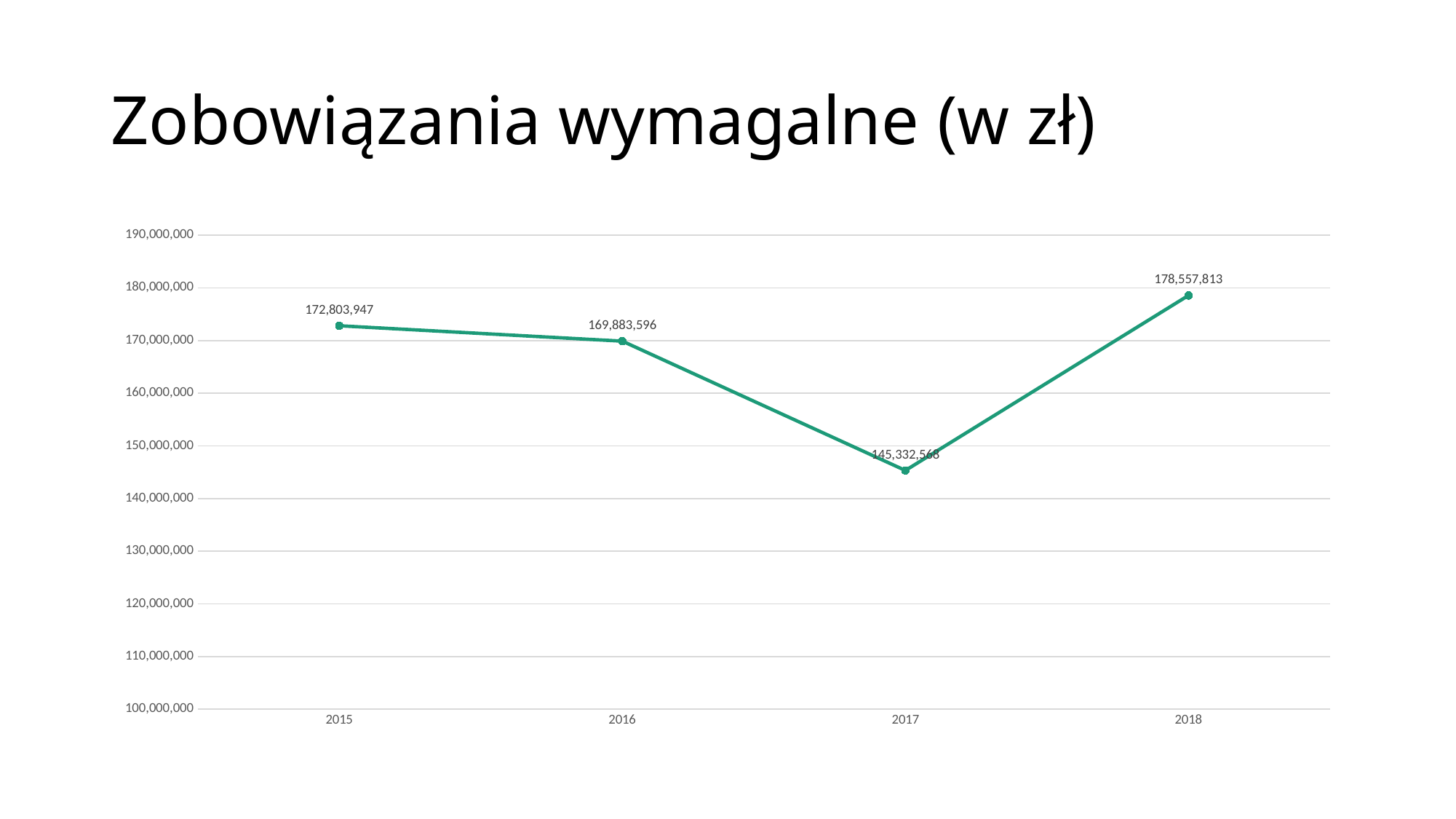
Which year has the lowest value? 2017 What is the value for 2018? 178,557,813 What is the value for 2017? 145,332,568 What is the value for 2015? 172,803,947 How many years are plotted on the chart? 4 Which year has the highest value? 2018 What is the difference between the values for 2015 and 2016? 2,920,351 What is the difference between the values for 2018 and 2017? 33,225,245 What is the title of the slide? Zobowiązania wymagalne (w zł) What kind of chart is shown on the slide? line chart Is the value for 2017 greater or less than 150,000,000? less Which is larger, the value for 2015 or the value for 2016? 2015